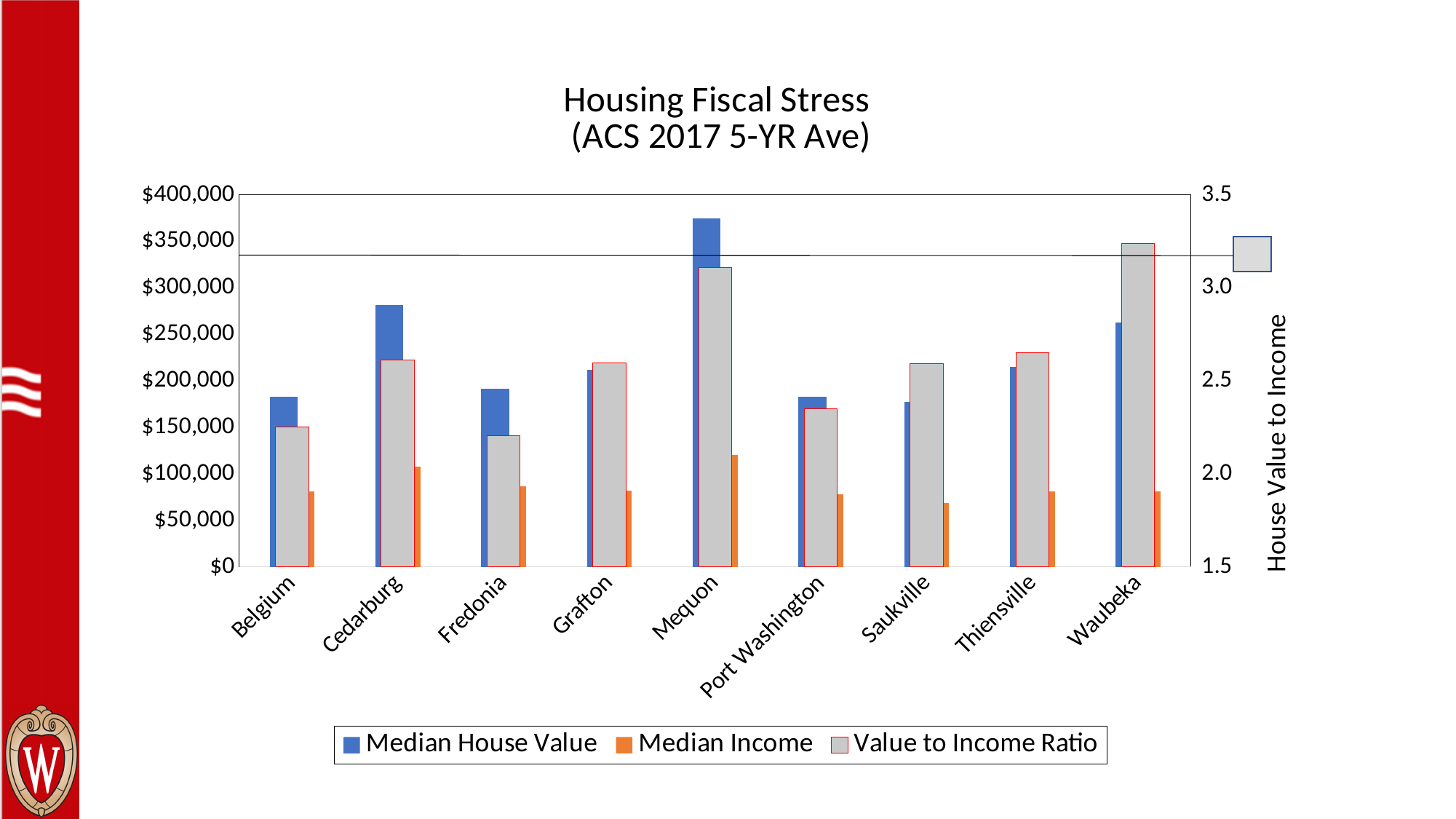
Is the Median House Value for Mequon greater or less than $350,000? greater How many series does the chart legend list? 3 Which community has the highest Median House Value? Mequon Which is larger, the Median House Value for Cedarburg or for Grafton? Cedarburg Which community has the highest Value to Income Ratio? Waubeka Is the Value to Income Ratio for Belgium greater or less than 2.5? less How many communities are shown on the x axis of the chart? 9 What is the title of the secondary (right-hand) vertical axis? House Value to Income Is the Median Income for Saukville greater or less than $100,000? less Which community has the highest Median Income? Mequon What kind of chart is shown on the slide? Bar chart